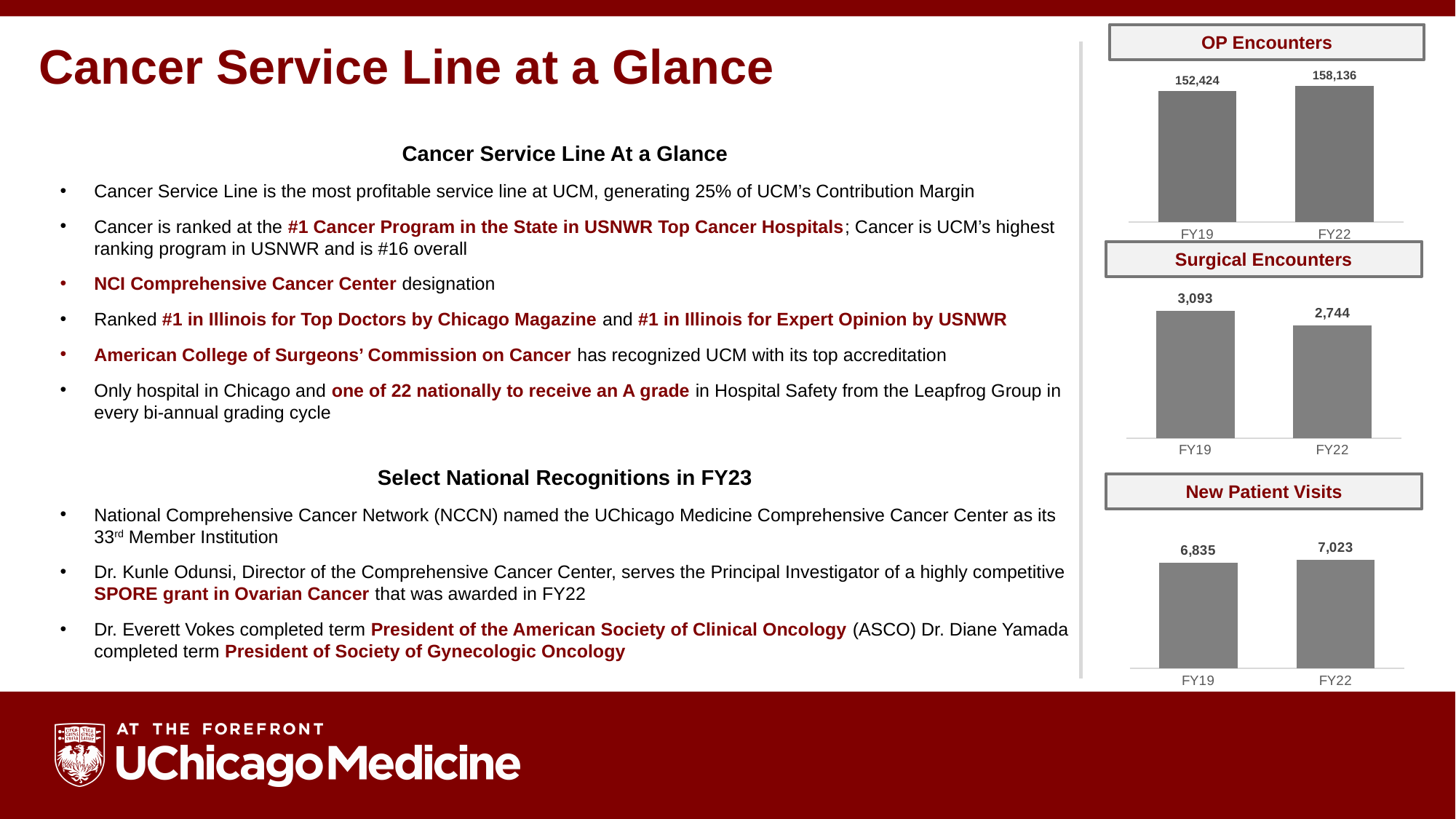
In the Surgical Encounters chart, which year has the higher value, FY19 or FY22? FY19 In the OP Encounters chart, what is the difference between FY22 and FY19? 5,712 In the Surgical Encounters chart, what is the value for FY19? 3,093 In the OP Encounters chart, what is the value for FY22? 158,136 In the New Patient Visits chart, what is the value for FY22? 7,023 In the New Patient Visits chart, do values rise or fall from FY19 to FY22? rise In the Surgical Encounters chart, what is the value for FY22? 2,744 In the New Patient Visits chart, what is the difference between FY22 and FY19? 188 What kind of chart is the Surgical Encounters chart? bar chart In the OP Encounters chart, what is the value for FY19? 152,424 In the Surgical Encounters chart, what is the difference between FY19 and FY22? 349 How many categories are shown in the OP Encounters chart? 2